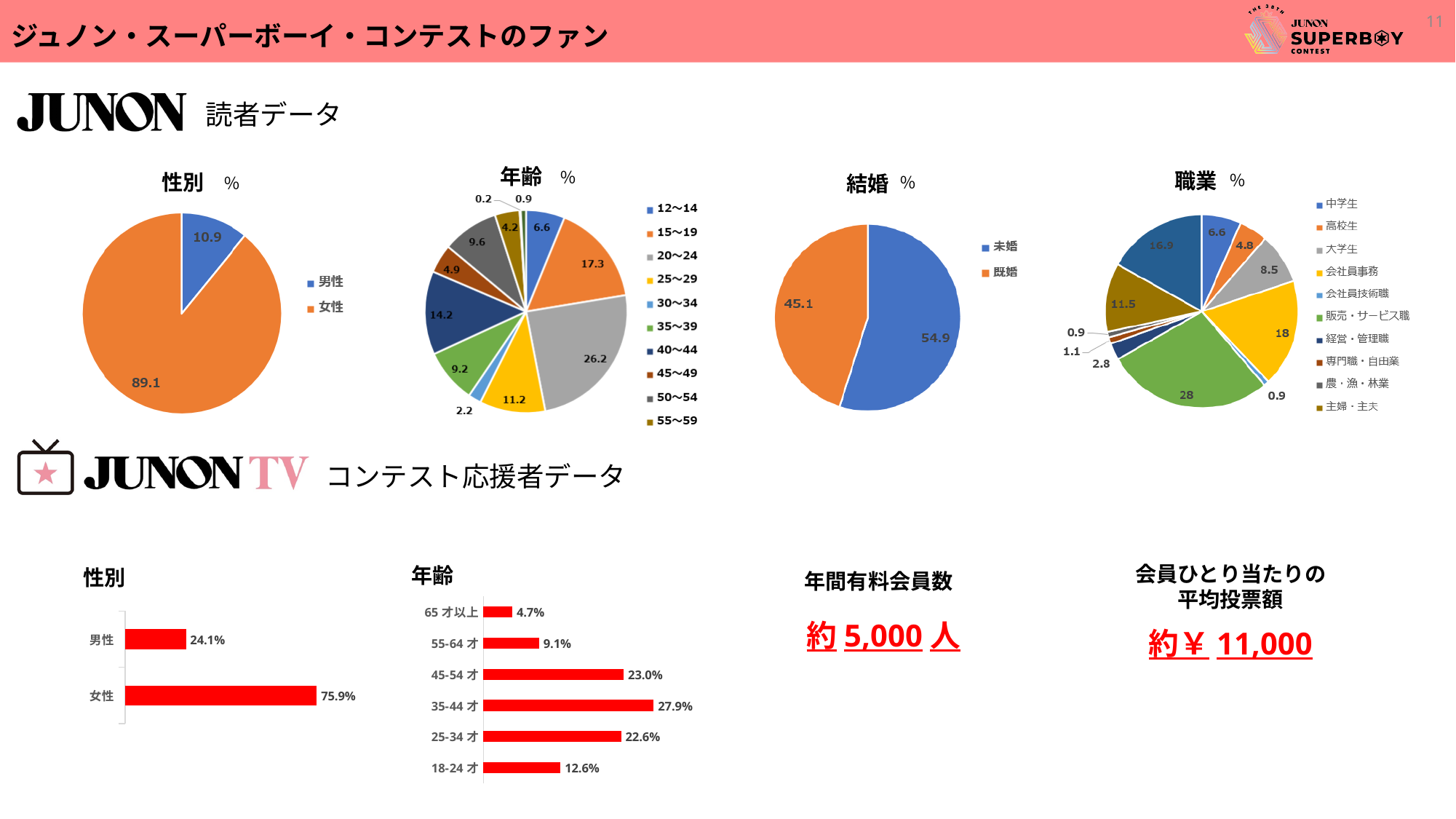
In the JUNON TV 年齢 bar chart, which age group has the highest value? 35-44 才 In the JUNON 読者データ 結婚 pie chart, what is the difference between 未婚 and 既婚? 9.8 In the JUNON TV 性別 chart, what is the value for 男性? 24.1% In the JUNON TV 年齢 bar chart, what is the difference between 45-54 才 and 18-24 才? 10.4% In the JUNON 読者データ 職業 pie chart, what is the value for 販売・サービス職? 28 In the JUNON 読者データ 結婚 pie chart, what is the value for 未婚? 54.9 In the JUNON 読者データ 年齢 pie chart, which age group has the largest share? 20〜24 In the JUNON 読者データ 職業 pie chart, which is larger, 会社員事務 or 主婦・主夫? 会社員事務 In the JUNON 読者データ 年齢 pie chart, what is the value for 40〜44? 14.2 What kind of chart is the JUNON TV 年齢 chart? bar chart In the JUNON 読者データ 性別 pie chart, what percentage is 女性? 89.1 How many entries does the legend of the JUNON 読者データ 職業 pie chart list? 10